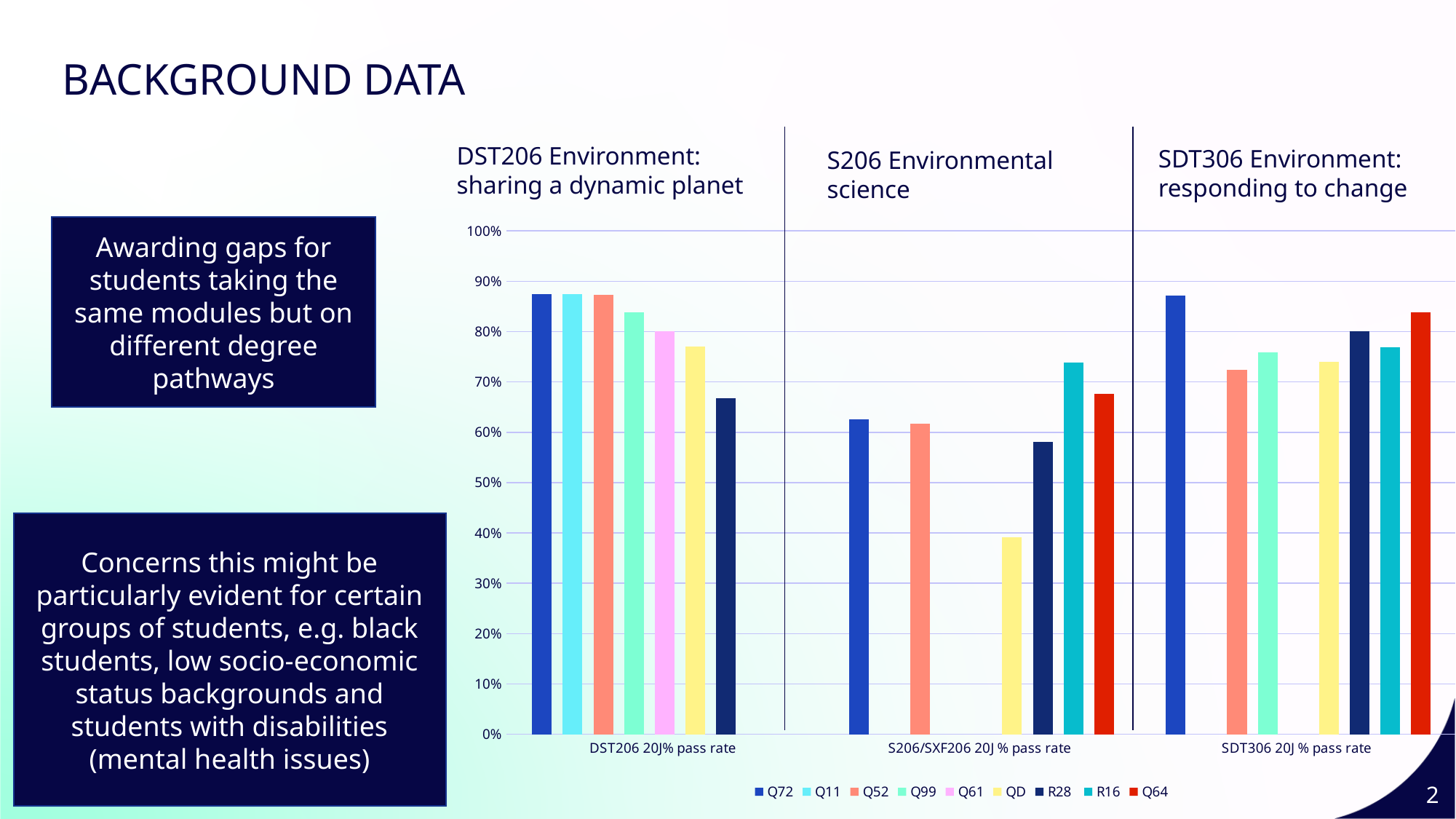
Is the value for Q72 in the DST206 20J% pass rate category greater or less than 80%? greater Which series is listed first in the chart's legend? Q72 How many module categories are shown along the x axis of the chart? 3 What kind of chart is shown on the slide? bar chart How many series does the chart's legend list? 9 In the S206/SXF206 20J % pass rate category, which is larger: the value for R16 or the value for Q64? R16 Is the value for R16 in the SDT306 20J % pass rate category greater or less than 80%? less Which series has the lowest value in the DST206 20J% pass rate category? R28 Is the value for QD in the S206/SXF206 20J % pass rate category greater or less than 50%? less Which series has the highest value in the S206/SXF206 20J % pass rate category? R16 Which series has the lowest value in the S206/SXF206 20J % pass rate category? QD Which series has the highest value in the SDT306 20J % pass rate category? Q72